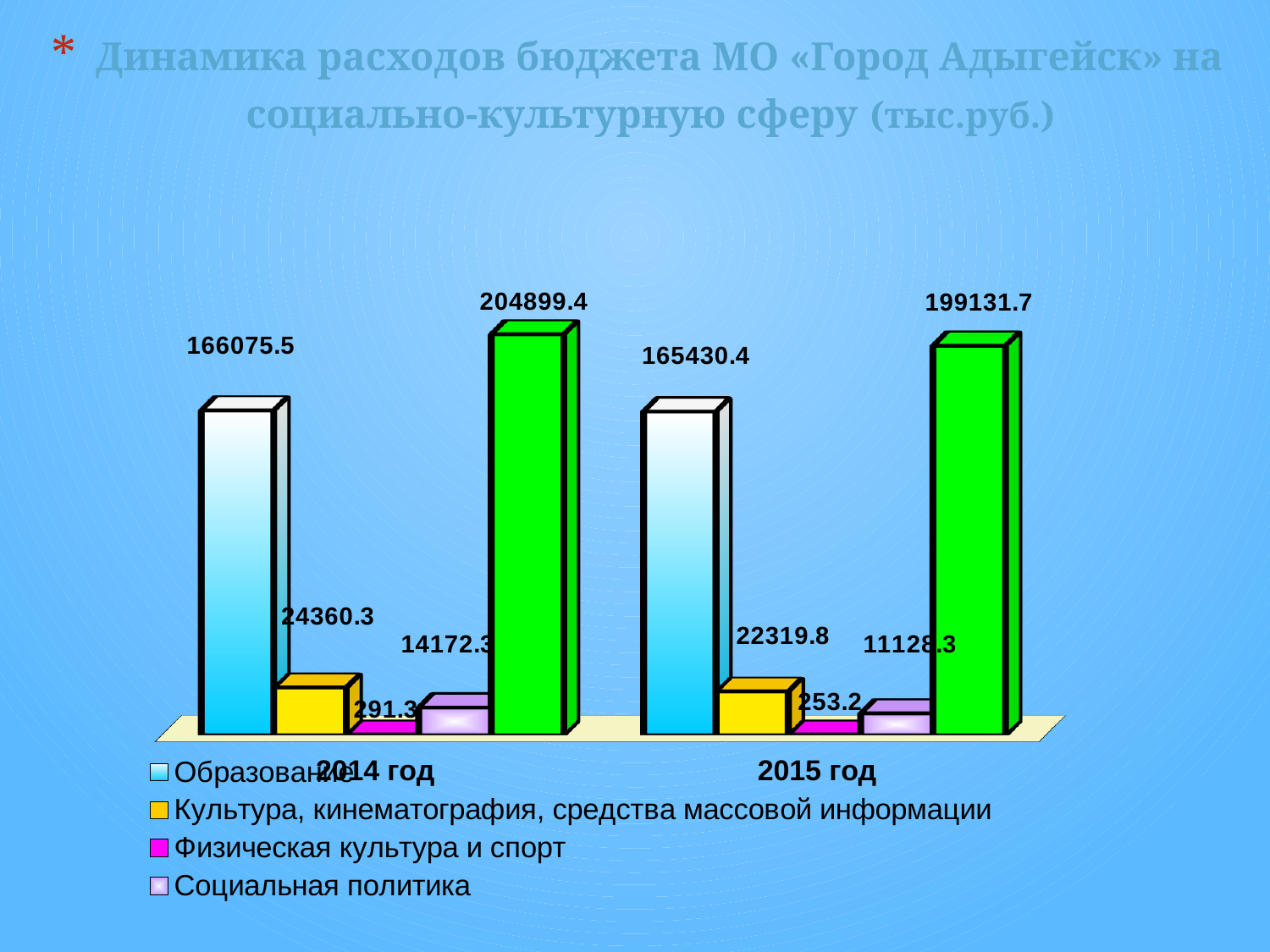
What kind of chart is shown on the slide? bar chart What is the value for Социальная политика in 2014 год? 14172.3 How many year categories are shown on the x axis? 2 What is the difference between the 2014 год and 2015 год values for Культура, кинематография, средства массовой информации? 2040.5 What is the value for Образование in 2014 год? 166075.5 How many series does the legend list? 4 Does the value for Образование rise or fall from 2014 год to 2015 год? fall What is the value for Физическая культура и спорт in 2015 год? 253.2 Among the series listed in the legend, which has the lowest value in 2015 год? Физическая культура и спорт By how much did the value for Образование change from 2014 год to 2015 год? 645.1 What is the value for Культура, кинематография, средства массовой информации in 2015 год? 22319.8 Which year has the larger value for Социальная политика, 2014 год or 2015 год? 2014 год